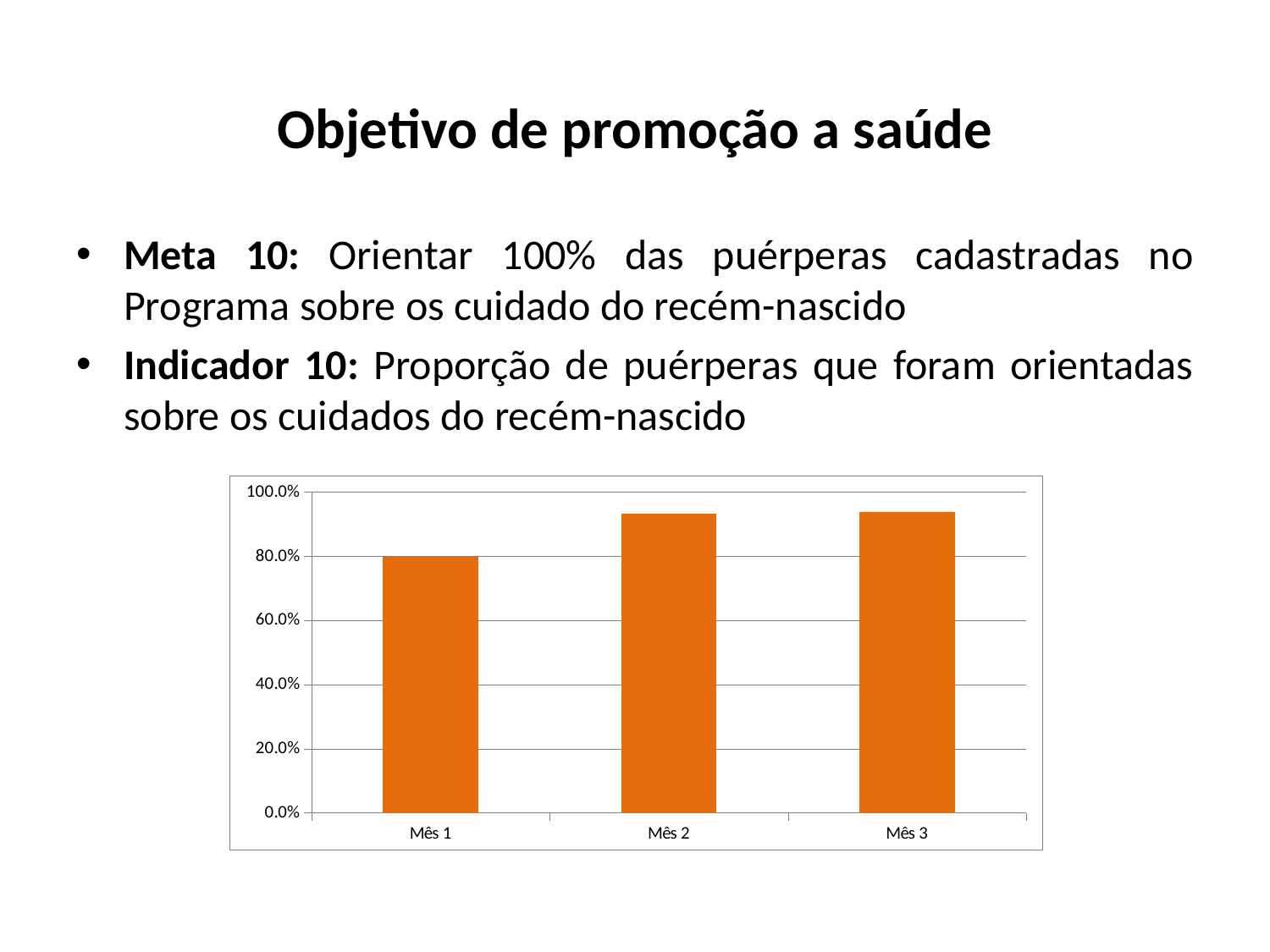
Which is larger, the value for Mês 1 or the value for Mês 3? Mês 3 Is the value for Mês 3 greater or less than 80.0%? greater Is the value for Mês 2 greater or less than 80.0%? greater What is the value for Mês 1 in the chart? 80.0% Which is larger, the value for Mês 1 or the value for Mês 2? Mês 2 How many categories are shown on the x axis of the chart? 3 Which category has the lowest value in the chart? Mês 1 Do the values rise or fall from Mês 1 to Mês 3? rise What is the highest value shown on the y axis of the chart? 100.0% Is the value for Mês 2 greater or less than 100.0%? less What colour are the bars in the chart? orange What kind of chart is shown on the slide? bar chart